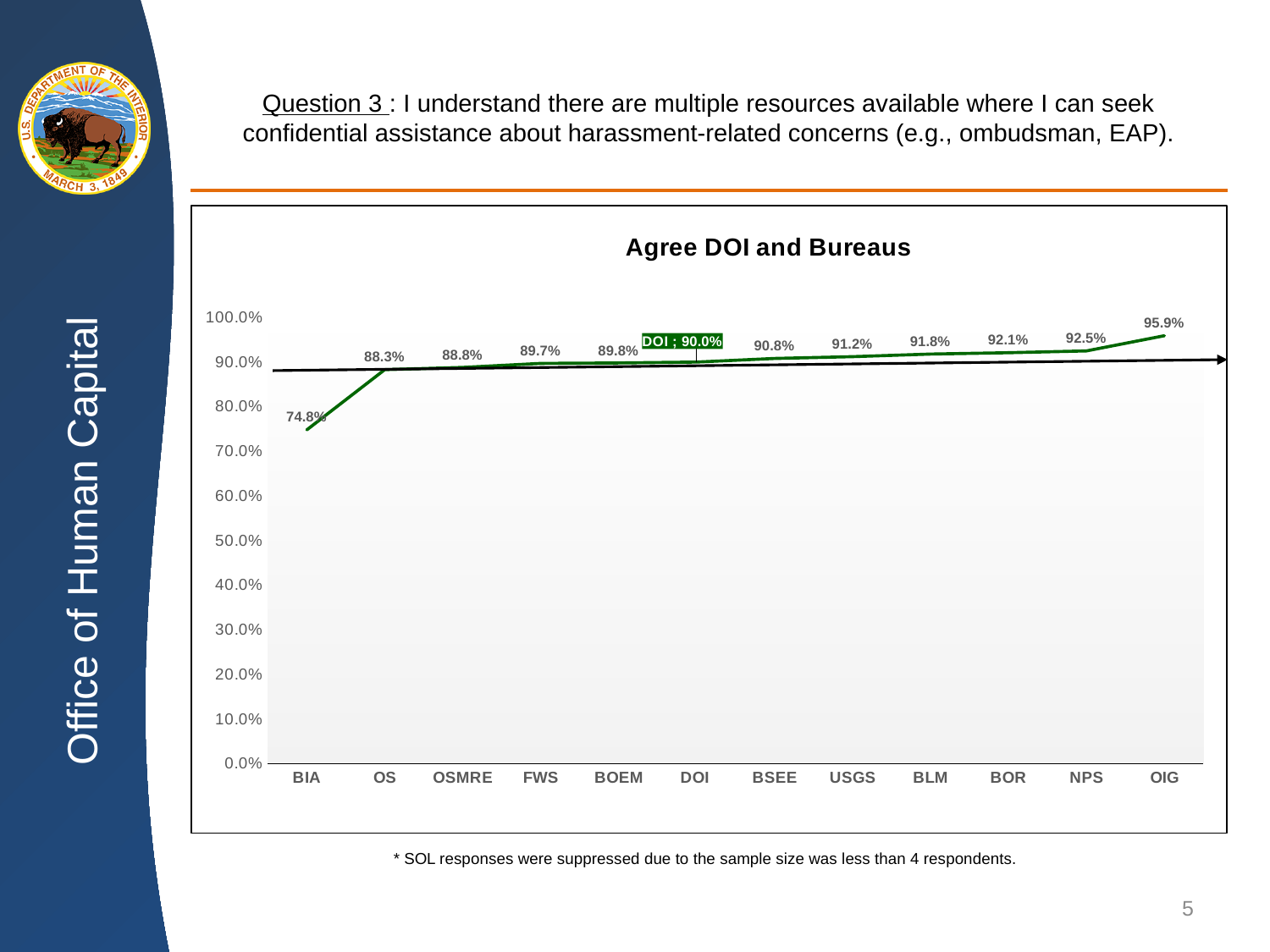
What is the value for BIA? 74.8% Which is larger, the value for NPS or the value for OS? NPS Is the value for BIA greater or less than 80.0%? less What is the value for OIG? 95.9% How many categories are shown on the x axis? 12 What is the value for USGS? 91.2% What is the difference between the values for OIG and BIA? 21.1% What kind of chart is this? line chart Which category has the highest value? OIG What is the title of the chart? Agree DOI and Bureaus Which category has the lowest value? BIA What is the value for DOI? 90.0%